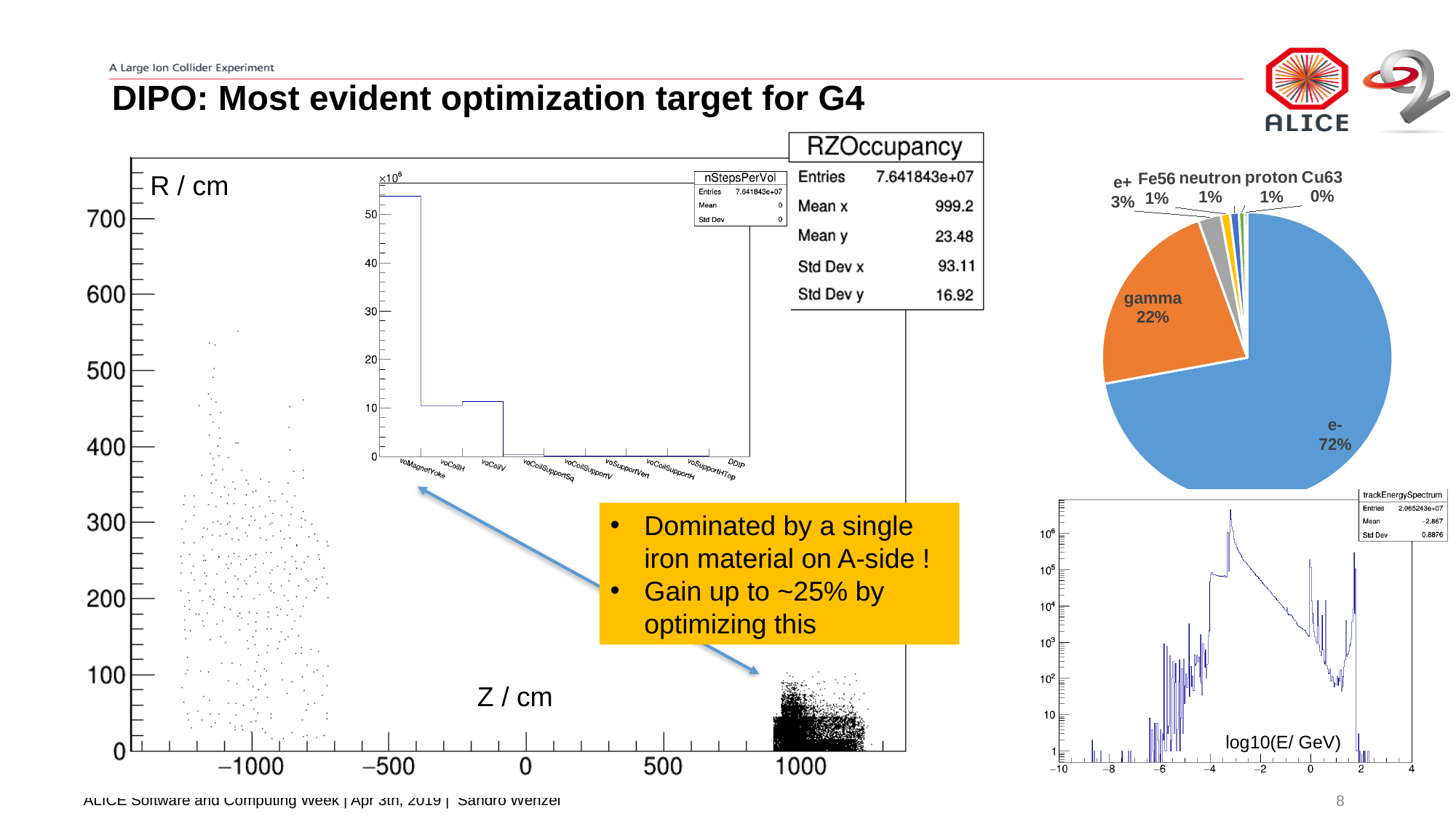
In the pie chart, which particle type has the largest slice? e- In the RZOccupancy chart, what is the Mean x value shown in the statistics box? 999.2 In the pie chart, what is the difference between the e- share and the gamma share? 50% In the pie chart, what share is labelled for e-? 72% In the RZOccupancy chart, what is the number of entries shown in the statistics box? 7.641843e+07 In the nStepsPerVol chart, which volume has the highest number of steps? voMagnetYoke In the nStepsPerVol chart, how many volume categories are shown on the x axis? 9 In the pie chart, what share is labelled for gamma? 22% In the pie chart, how many slices (particle types) are labelled? 7 In the pie chart, which particle type is labelled with 0%? Cu63 In the nStepsPerVol chart, is the value for voMagnetYoke greater or less than 50 (×10^6)? greater In the pie chart, what share is labelled for e+? 3%